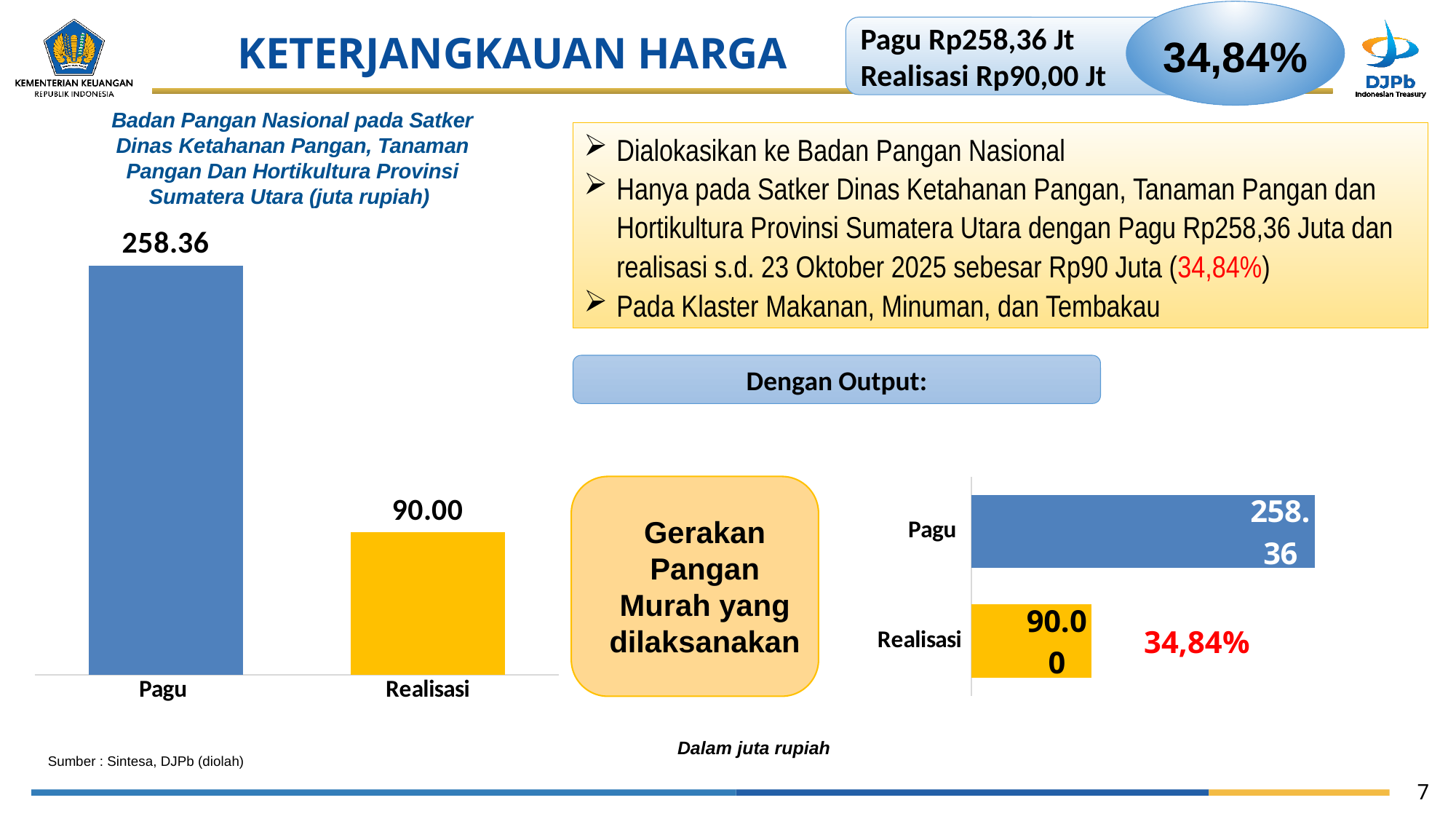
How many categories are shown in the left chart? 2 In the left chart, what is the difference between the Pagu and Realisasi values? 168.36 In the left chart, what colour is the Realisasi bar? Yellow What kind of chart is the chart on the right under 'Dengan Output:'? Bar chart In the horizontal bar chart on the right (under 'Dengan Output:'), what is the value for Realisasi? 90.00 In the horizontal bar chart on the right (under 'Dengan Output:'), what is the value for Pagu? 258.36 In the left chart titled 'Badan Pangan Nasional pada Satker Dinas Ketahanan Pangan...', what is the value for Realisasi? 90.00 In the left chart, which category has the lowest value? Realisasi What kind of chart is the left chart? Bar chart In the left chart titled 'Badan Pangan Nasional pada Satker Dinas Ketahanan Pangan...', what is the value for Pagu? 258.36 In the left chart, which category has the highest value? Pagu In the left chart, which is larger, Pagu or Realisasi? Pagu